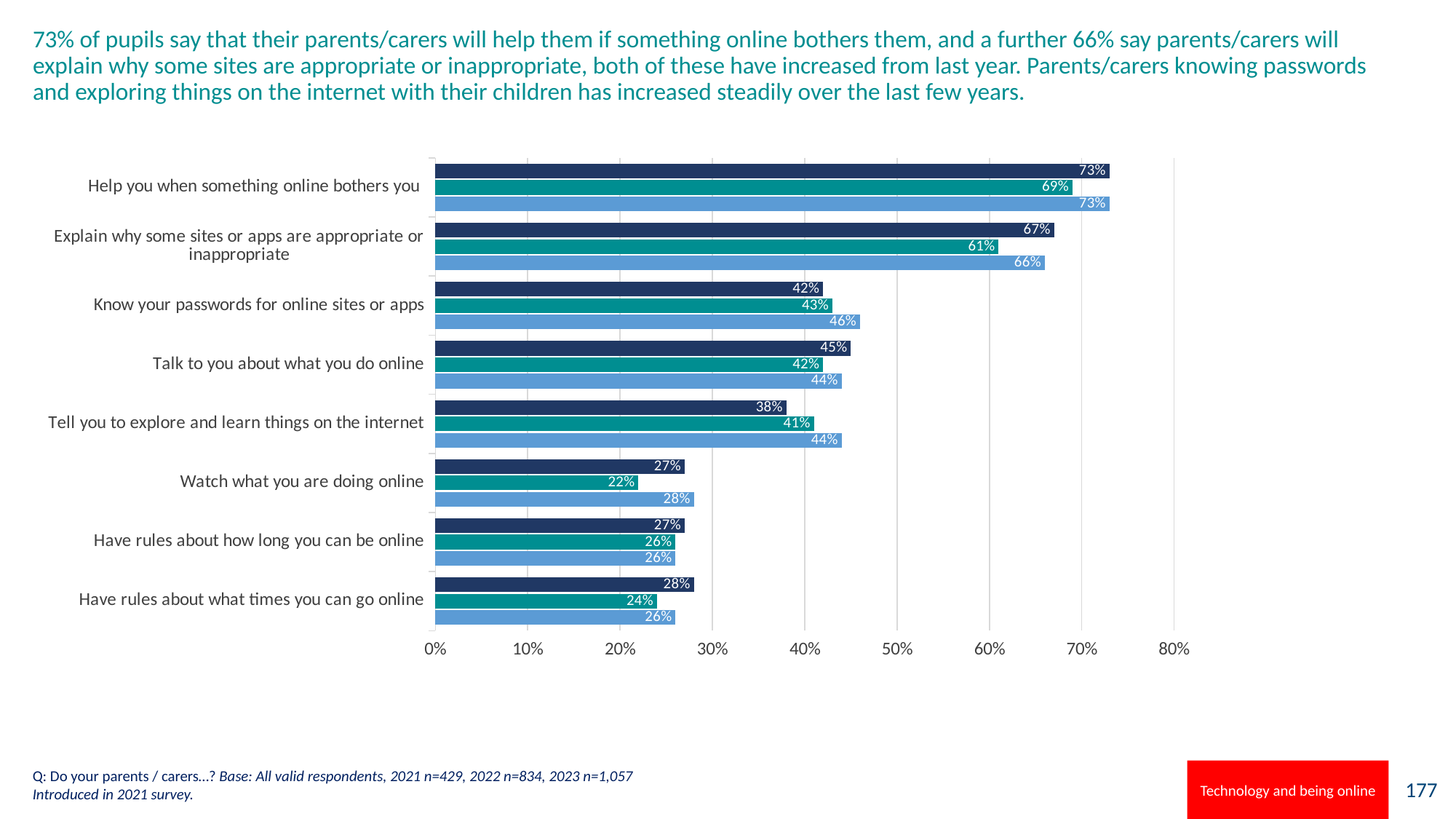
How many bars are shown for each category in the chart? 3 For 'Talk to you about what you do online', which is larger: the dark navy (top) bar or the teal (middle) bar? the dark navy (top) bar Which category has the highest value among the light blue (bottom) bars? Help you when something online bothers you What is the value of the dark navy (top) bar for 'Tell you to explore and learn things on the internet'? 38% Which category has the lowest value among the teal (middle) bars? Watch what you are doing online What is the value of the light blue (bottom) bar for 'Know your passwords for online sites or apps'? 46% What type of chart is shown on the slide? bar chart How many categories are listed on the vertical axis of the chart? 8 What is the value of the teal (middle) bar for 'Explain why some sites or apps are appropriate or inappropriate'? 61% What is the value of the light blue (bottom) bar for 'Help you when something online bothers you'? 73% What is the highest value shown on the horizontal axis of the chart? 80% What is the difference between the light blue (bottom) bar and the teal (middle) bar for 'Explain why some sites or apps are appropriate or inappropriate'? 5%